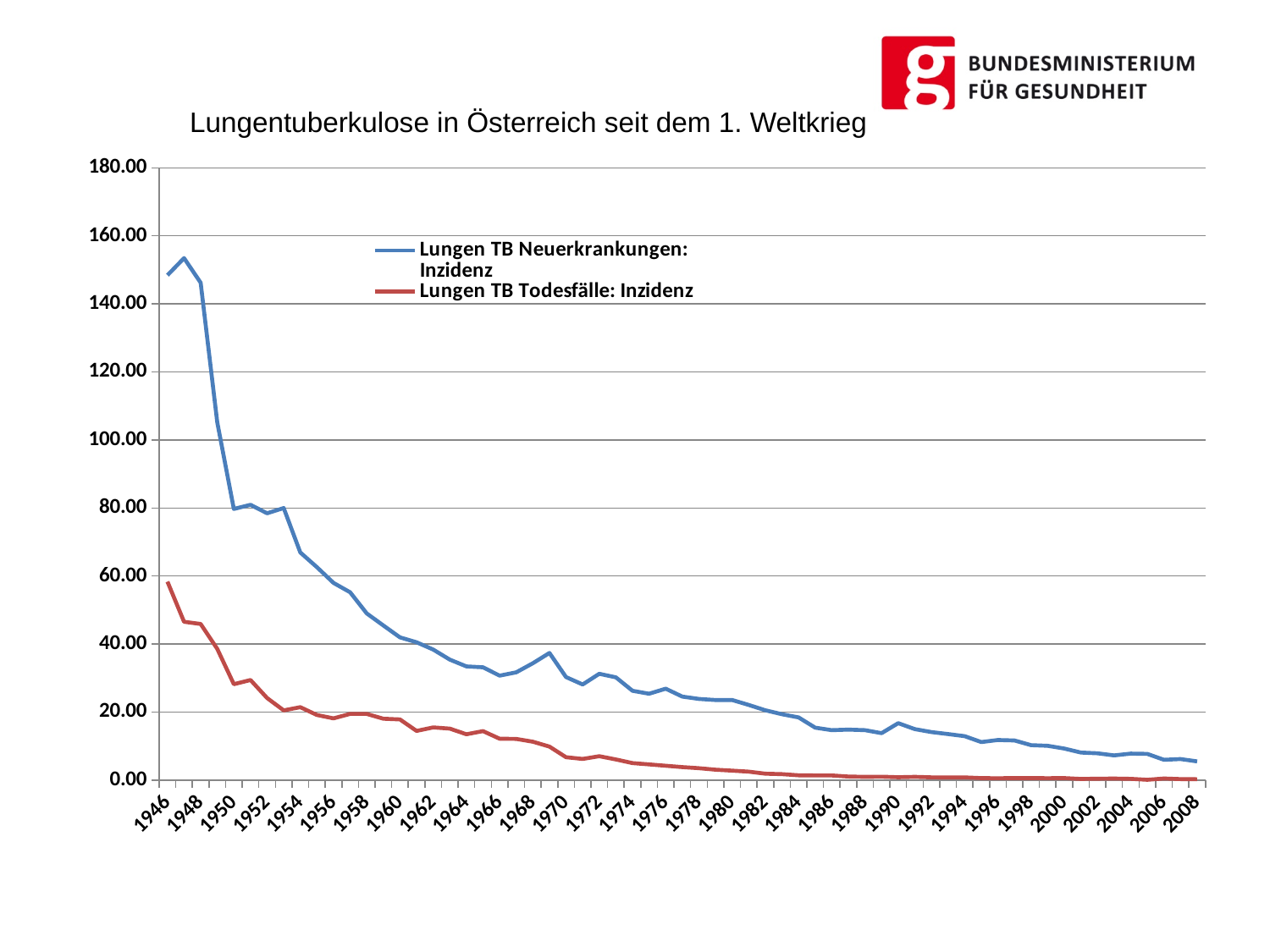
Which series is drawn in red? Lungen TB Todesfälle: Inzidenz Is the value for 'Lungen TB Neuerkrankungen: Inzidenz' in 1980 greater or less than 40? less Is the value for 'Lungen TB Neuerkrankungen: Inzidenz' in 1950 greater or less than 100? less How many series does the legend list? 2 Do the values of the 'Lungen TB Neuerkrankungen: Inzidenz' series rise or fall overall from 1946 to 2008? fall In 1946, which series has the larger value: 'Lungen TB Neuerkrankungen: Inzidenz' or 'Lungen TB Todesfälle: Inzidenz'? Lungen TB Neuerkrankungen: Inzidenz Is the value for 'Lungen TB Todesfälle: Inzidenz' in 1954 greater or less than 40? less What is the last year shown on the x axis? 2008 What kind of chart is shown on the slide? line chart What is the title of the chart? Lungentuberkulose in Österreich seit dem 1. Weltkrieg